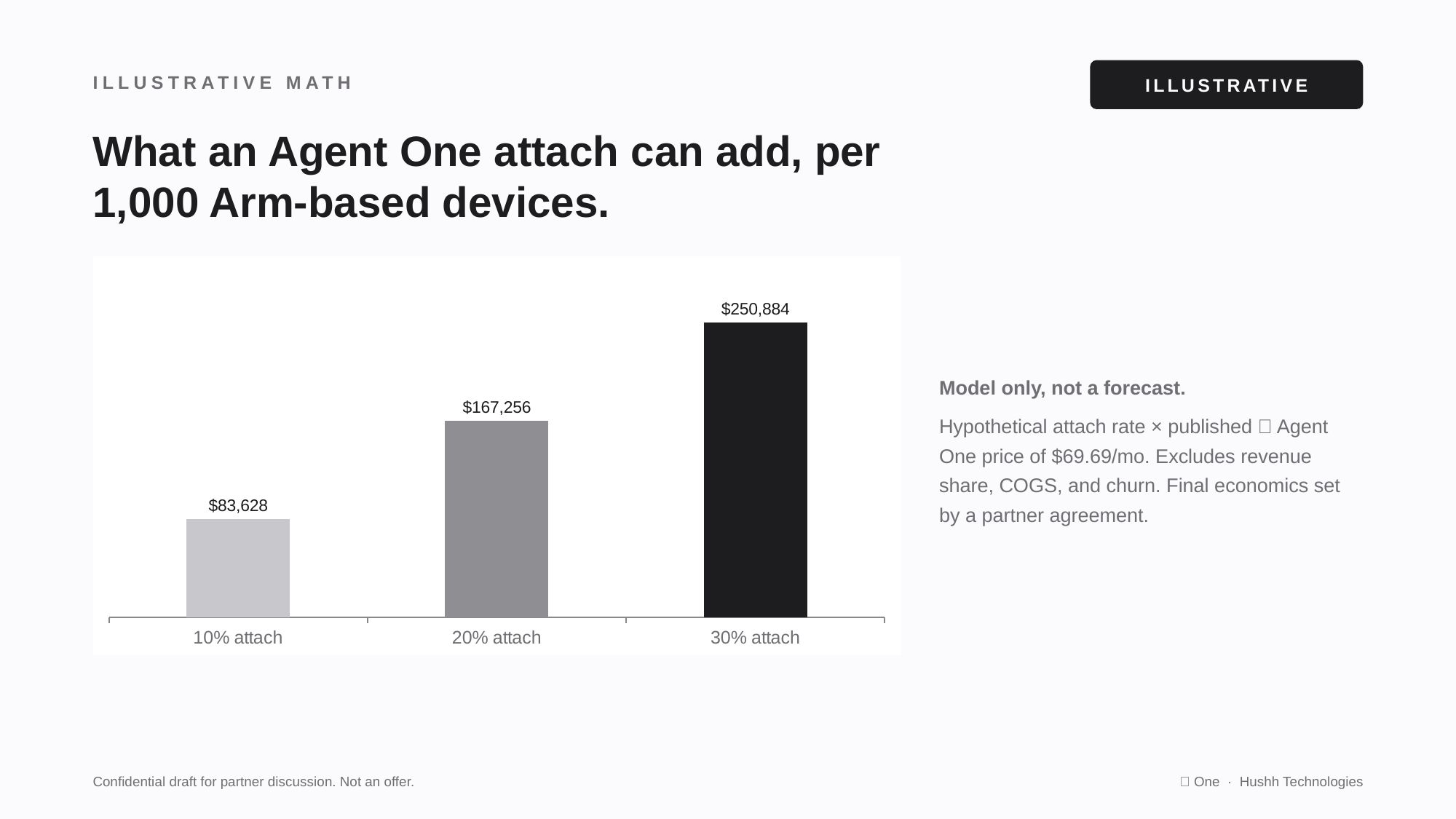
What is the difference between the values for 20% attach and 10% attach? $83,628 Which attach rate has the highest value? 30% attach What is the value for 30% attach? $250,884 What is the value for 10% attach? $83,628 How many categories are shown on the chart? 3 Do the values rise or fall as the attach rate increases along the x axis? Rise What is the title of the slide containing the chart? What an Agent One attach can add, per 1,000 Arm-based devices. Which attach rate has the lowest value? 10% attach What kind of chart is shown on the slide? Bar chart Which is larger, the value for 20% attach or the value for 30% attach? 30% attach What is the value for 20% attach? $167,256 What is the difference between the values for 30% attach and 10% attach? $167,256